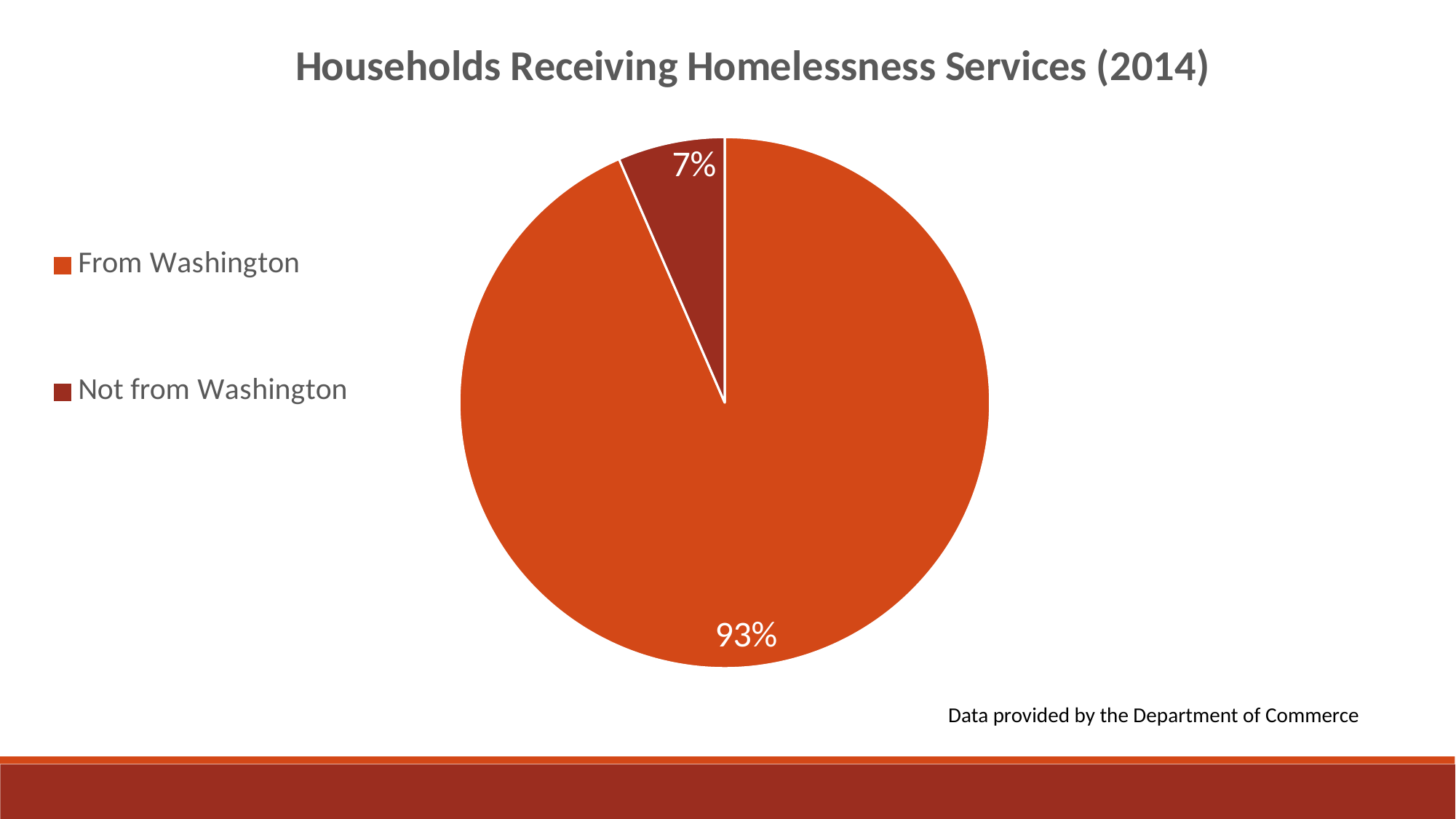
Which category has the smallest slice of the pie? Not from Washington Which category has the largest slice of the pie? From Washington What is the difference in percentage points between the From Washington and Not from Washington slices? 86 What kind of chart is shown on the slide? Pie chart Which is larger: the share From Washington or the share Not from Washington? From Washington How many entries does the legend list? 2 How many categories does the pie chart show? 2 What share of households receiving homelessness services were from Washington? 93% What is the title of the chart? Households Receiving Homelessness Services (2014) Which category is shown in the darker red colour? Not from Washington What share of households receiving homelessness services were not from Washington? 7%